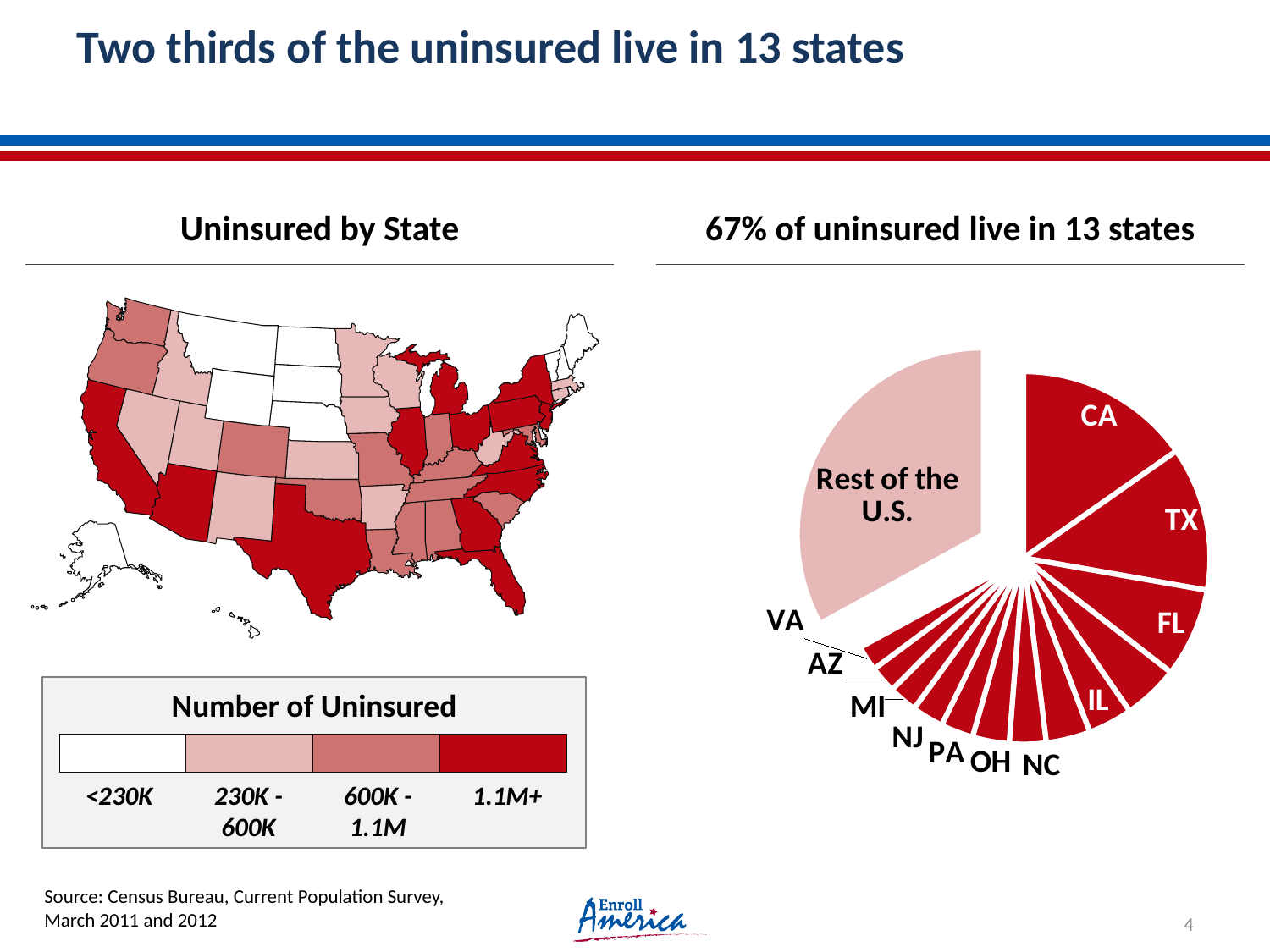
In the pie chart, which slice is the largest overall? Rest of the U.S. How many state slices in the pie chart are labeled with a state abbreviation? 11 In the map chart 'Uninsured by State', how many categories does the 'Number of Uninsured' legend show? 4 In the pie chart, which slice is larger, Rest of the U.S. or CA? Rest of the U.S. In the pie chart, which individual state has the largest slice? CA In the pie chart, which slice is larger, CA or TX? CA According to the pie chart's title, what percentage of the uninsured live in 13 states? 67% What kind of chart is shown on the right side of the slide under '67% of uninsured live in 13 states'? pie chart In the pie chart, which slice is larger, TX or FL? TX What is the title of the chart on the left side of the slide? Uninsured by State In the map chart 'Uninsured by State', what is the label of the highest legend category? 1.1M+